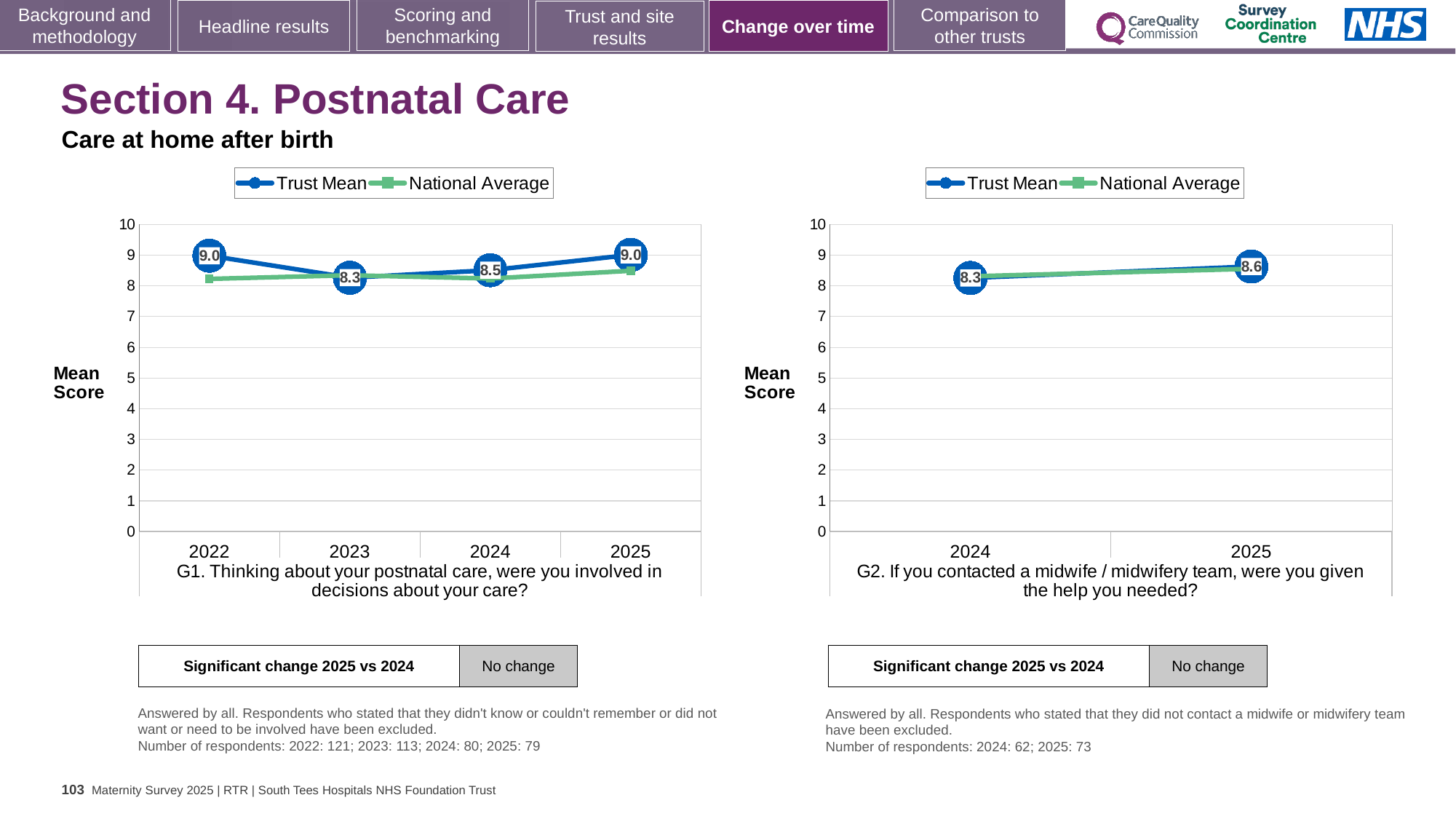
In the G2 chart on the right, is the Trust Mean higher in 2024 or 2025? 2025 In the G1 chart on the left, what is the difference between the Trust Mean in 2025 and in 2023? 0.7 What kind of chart is the G2 chart on the right? Line chart In the G1 chart on the left, what is the Trust Mean for 2022? 9.0 In the G1 chart on the left, what is the Trust Mean for 2024? 8.5 In the G1 chart on the left, which year has the lowest Trust Mean? 2023 In the G2 chart on the right, what is the Trust Mean for 2025? 8.6 In the G2 chart on the right, what is the Trust Mean for 2024? 8.3 How many series does the legend of the G2 chart on the right list? 2 In the G1 chart on the left, is the National Average for 2022 greater or less than 9? less In the G1 chart on the left, what is the Trust Mean for 2023? 8.3 How many years are plotted on the x axis of the G1 chart on the left? 4